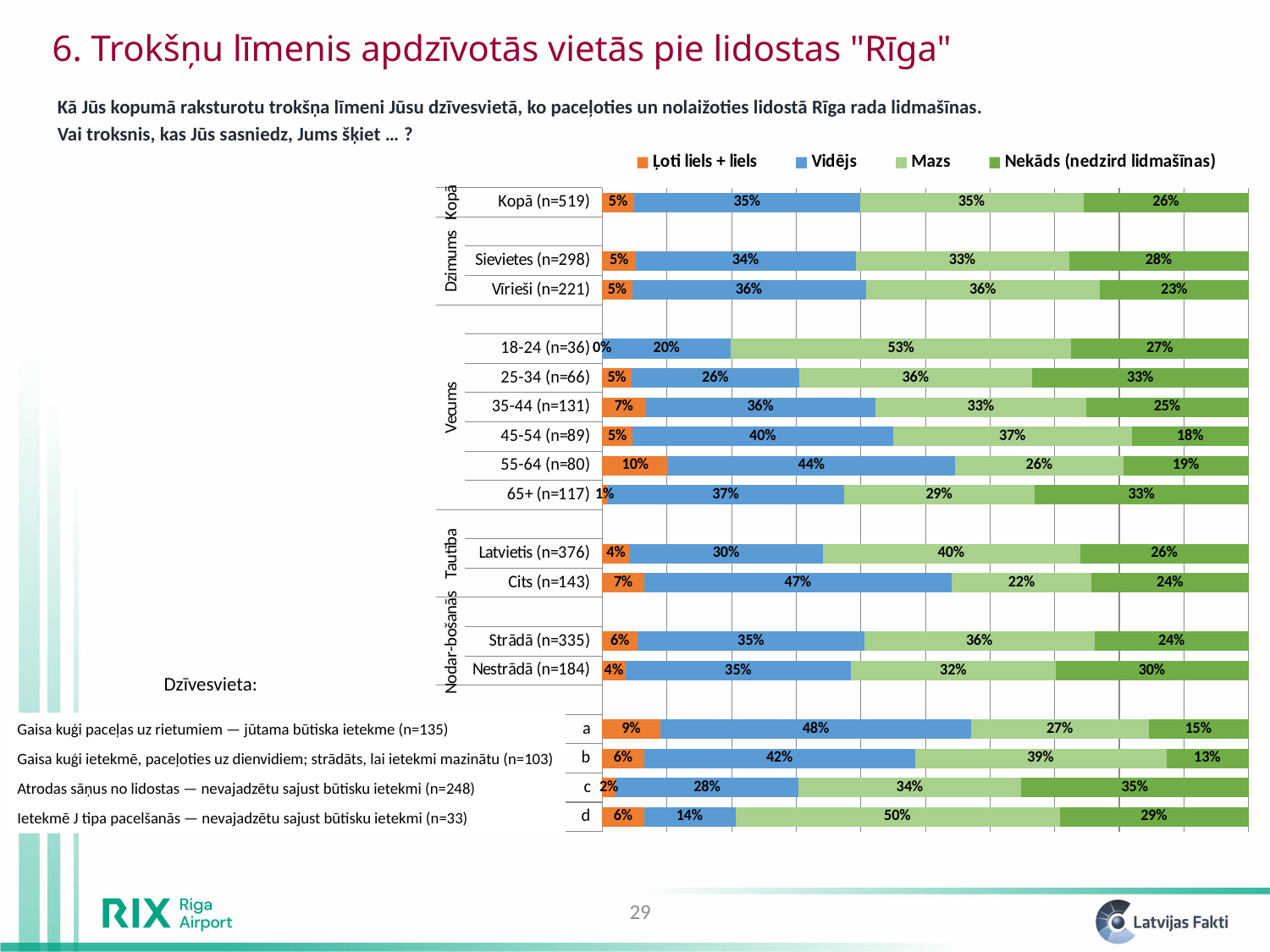
Which has the larger Vidējs value, Latvietis (n=376) or Cits (n=143)? Cits (n=143) What is the difference between the Nekāds (nedzird lidmašīnas) values for Sievietes (n=298) and Vīrieši (n=221)? 5 percentage points What is the value of Ļoti liels + liels for 55-64 (n=80)? 10% Which category has the lowest value for Ļoti liels + liels? 18-24 (n=36) What colour represents the Nekāds (nedzird lidmašīnas) series? Dark green What kind of chart is shown on the slide? Stacked bar chart What is the value of Mazs for row c? 34% What is the value of Vidējs for Kopā (n=519)? 35% Which category has the highest value for Mazs? 18-24 (n=36) What is the value of Nekāds (nedzird lidmašīnas) for 18-24 (n=36)? 27% How many series does the legend list? 4 What is the total of the stacked bar for 45-54 (n=89)? 100%